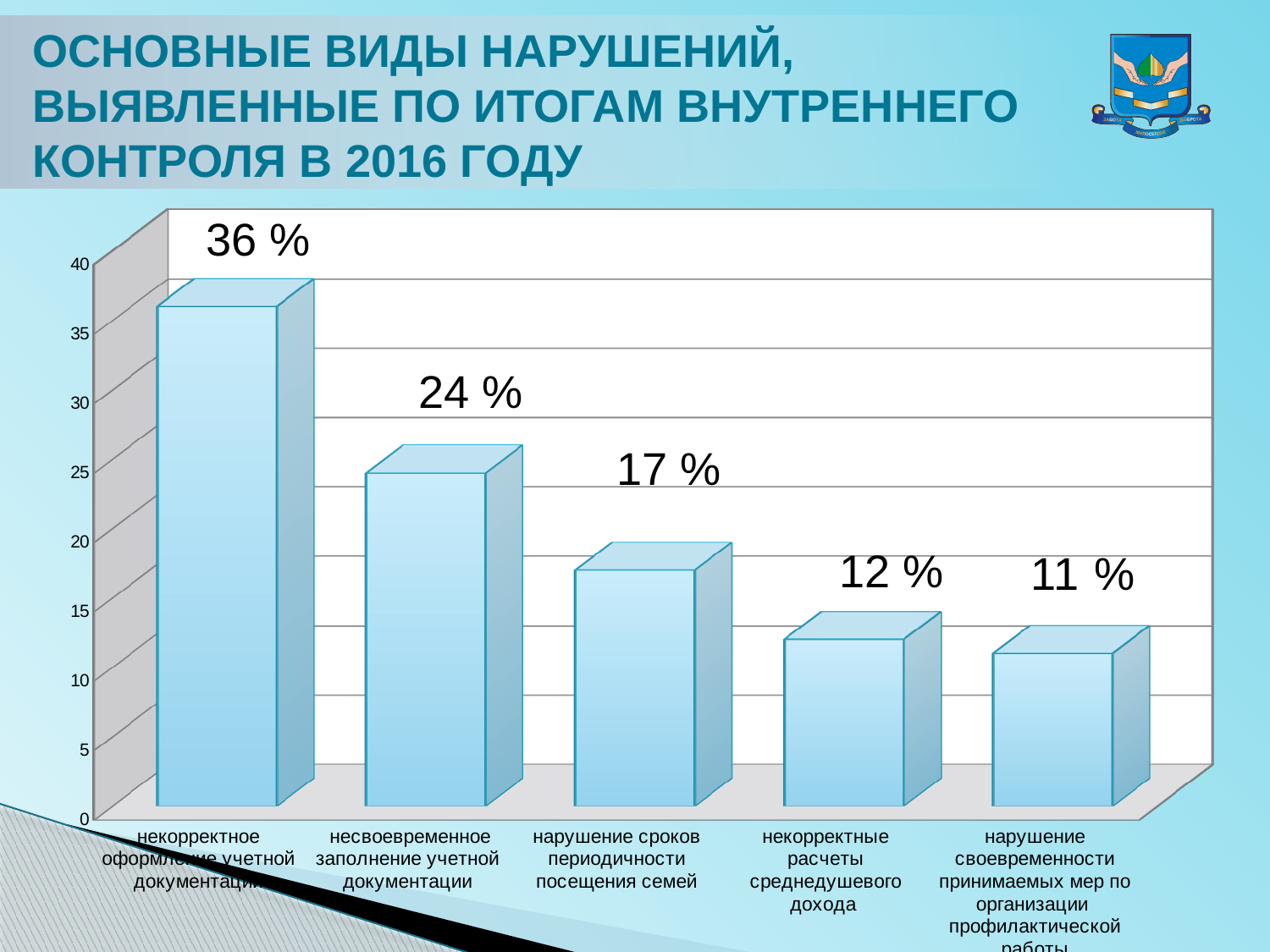
How many categories (bars) does the chart show? 5 What is the value for "нарушение сроков периодичности посещения семей"? 17 % What is the difference between the values for "несвоевременное заполнение учетной документации" and "нарушение сроков периодичности посещения семей"? 7 % Is the value for "нарушение сроков периодичности посещения семей" greater or less than 20? less What is the highest tick value shown on the vertical axis? 40 What is the value of the tallest bar in the chart? 36 % What is the value for "несвоевременное заполнение учетной документации"? 24 % Do the bar values rise or fall from left to right along the x axis? fall Which is larger: the value for "несвоевременное заполнение учетной документации" or the value for "некорректные расчеты среднедушевого дохода"? несвоевременное заполнение учетной документации Which category has the lowest value? нарушение своевременности принимаемых мер по организации профилактической работы What is the value for "некорректные расчеты среднедушевого дохода"? 12 % What kind of chart is shown on the slide? bar chart